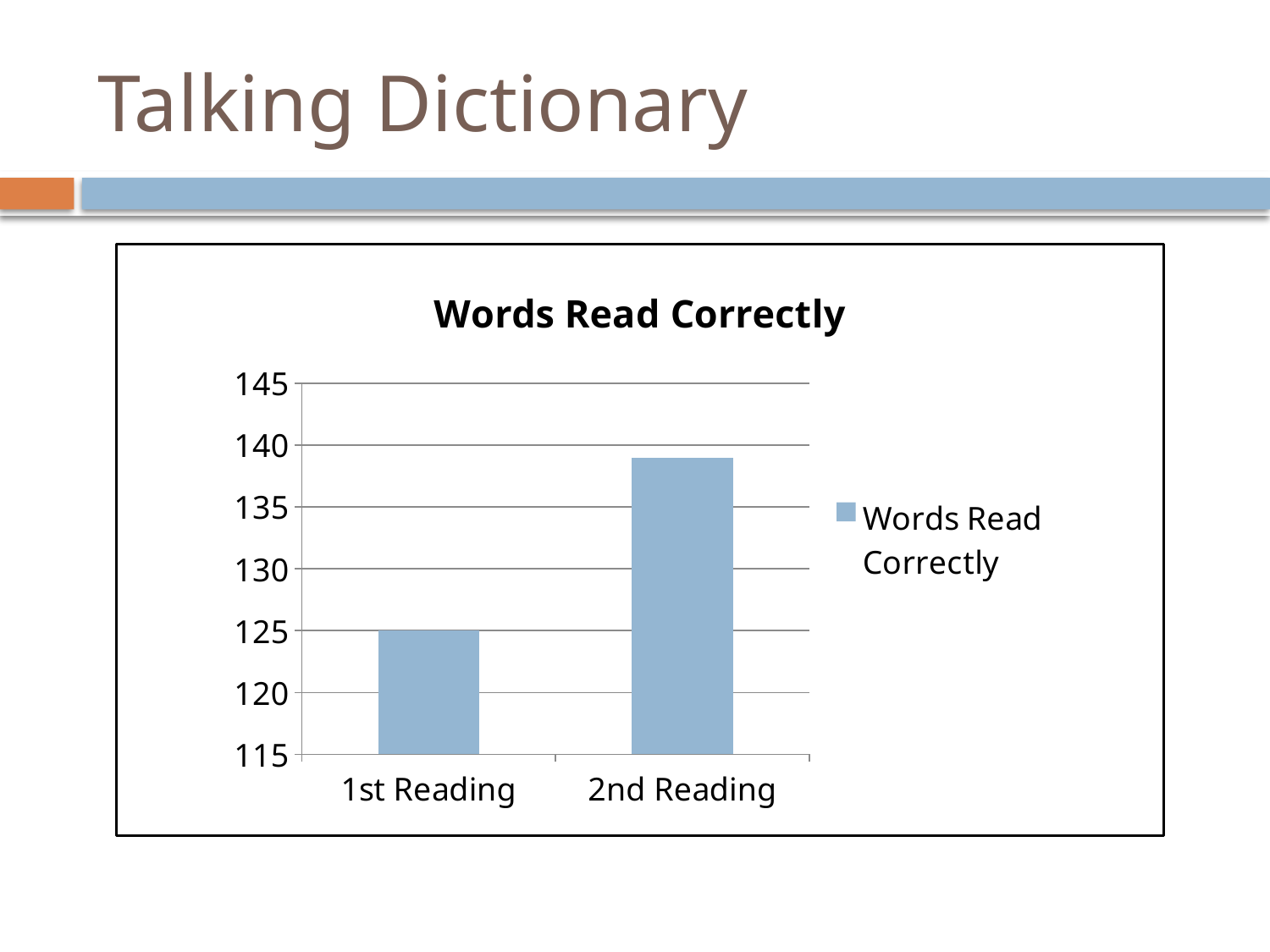
Which category has the highest value in the Words Read Correctly chart? 2nd Reading Do the values rise or fall from 1st Reading to 2nd Reading? rise Which category has the lowest value in the Words Read Correctly chart? 1st Reading How many series does the legend list? 1 Which is larger, the value for 1st Reading or the value for 2nd Reading? 2nd Reading Is the value for 1st Reading greater or less than 130? less How many categories are shown on the x axis of the chart? 2 What kind of chart is shown on the slide? bar chart What is the title of the chart? Words Read Correctly Is the value for 2nd Reading greater or less than 140? less Is the value for 2nd Reading greater or less than 135? greater What is the value for 1st Reading in the Words Read Correctly chart? 125